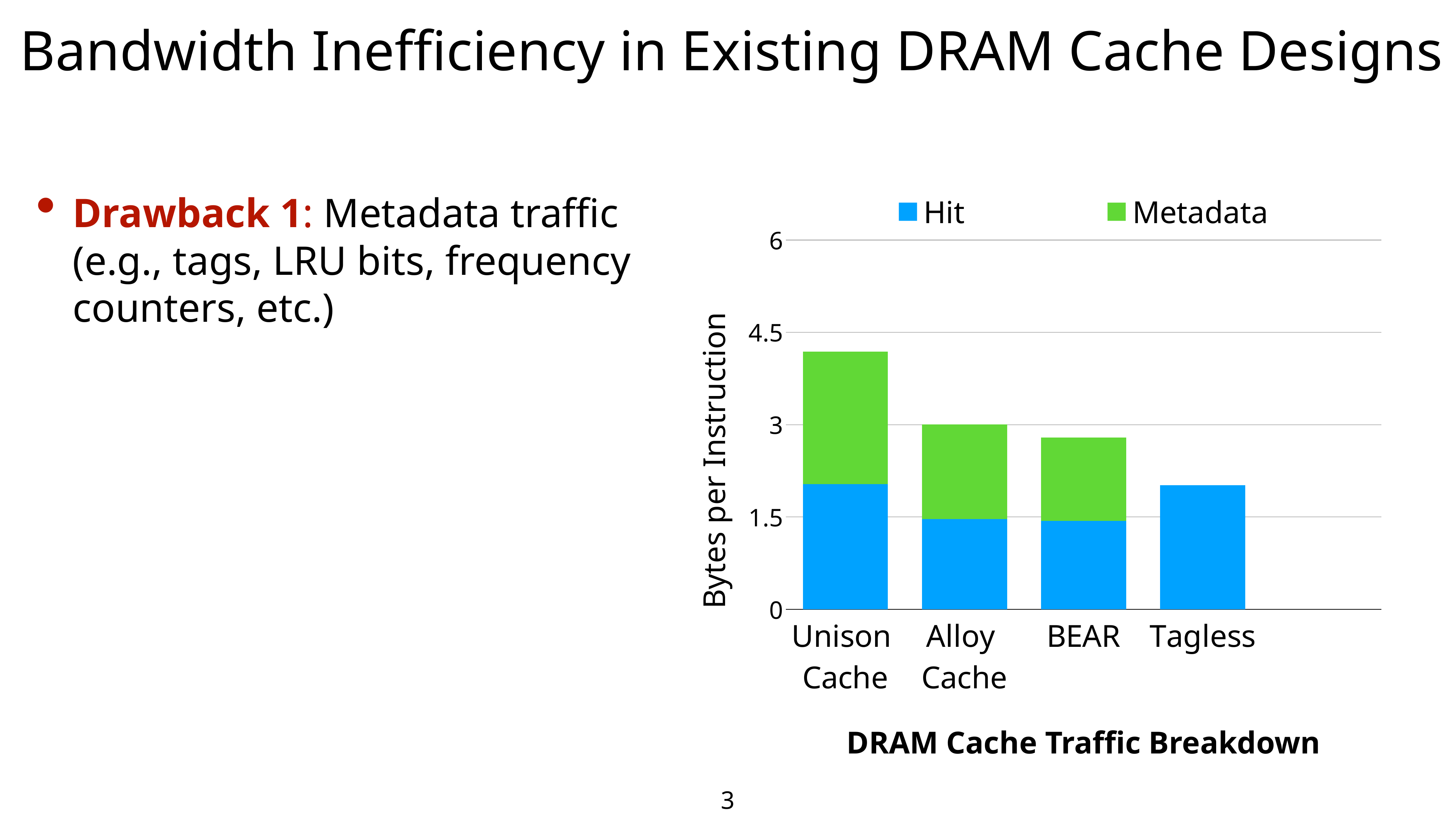
How many series does the legend list? 2 Which cache design has the lowest total bytes per instruction? Tagless How many cache designs are shown on the x axis? 4 Which has a larger total bytes per instruction, Unison Cache or BEAR? Unison Cache Do the total bytes per instruction rise or fall from Unison Cache to Tagless along the x axis? fall Is the total bytes per instruction for Unison Cache greater or less than 3? greater Is the total bytes per instruction for Tagless greater or less than 3? less Which cache design has the highest total bytes per instruction? Unison Cache Is the total bytes per instruction for Unison Cache greater or less than 4.5? less What is the title of the chart? DRAM Cache Traffic Breakdown What is the label of the vertical axis of the chart? Bytes per Instruction What kind of chart is shown on the slide? Stacked bar chart